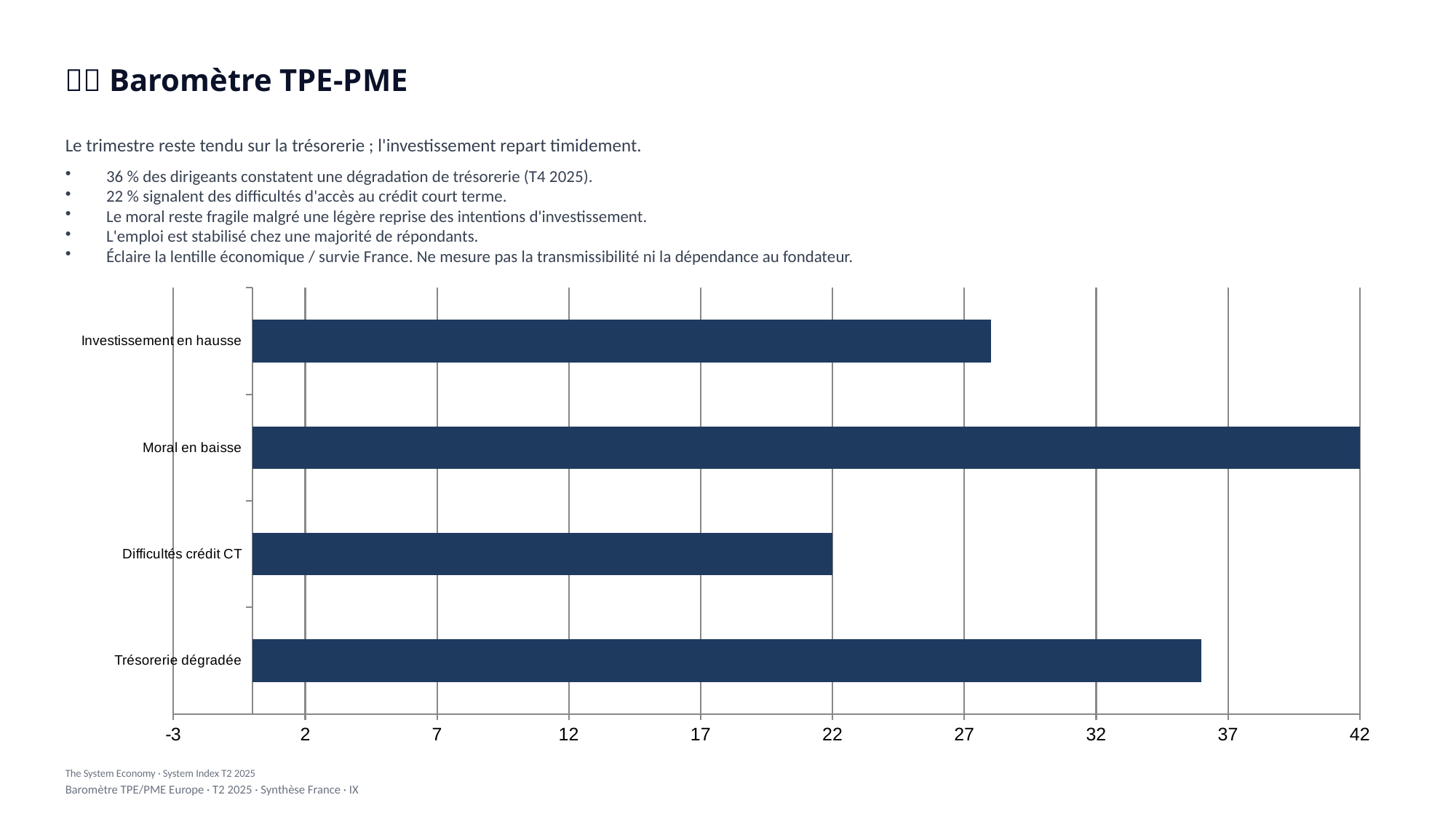
Which category has the lowest value in the chart? Difficultés crédit CT How many categories does the chart show? 4 What is the difference between the values for Moral en baisse and Difficultés crédit CT? 20 What is the value for Difficultés crédit CT? 22 Is the value for Trésorerie dégradée greater or less than 32? greater Is the value for Trésorerie dégradée greater or less than 37? less What is the highest value shown on the horizontal axis of the chart? 42 Which is larger, the value for Trésorerie dégradée or the value for Investissement en hausse? Trésorerie dégradée Which category has the highest value in the chart? Moral en baisse What kind of chart is shown on the slide? bar chart What is the value for Moral en baisse? 42 Is the value for Investissement en hausse greater or less than 32? less